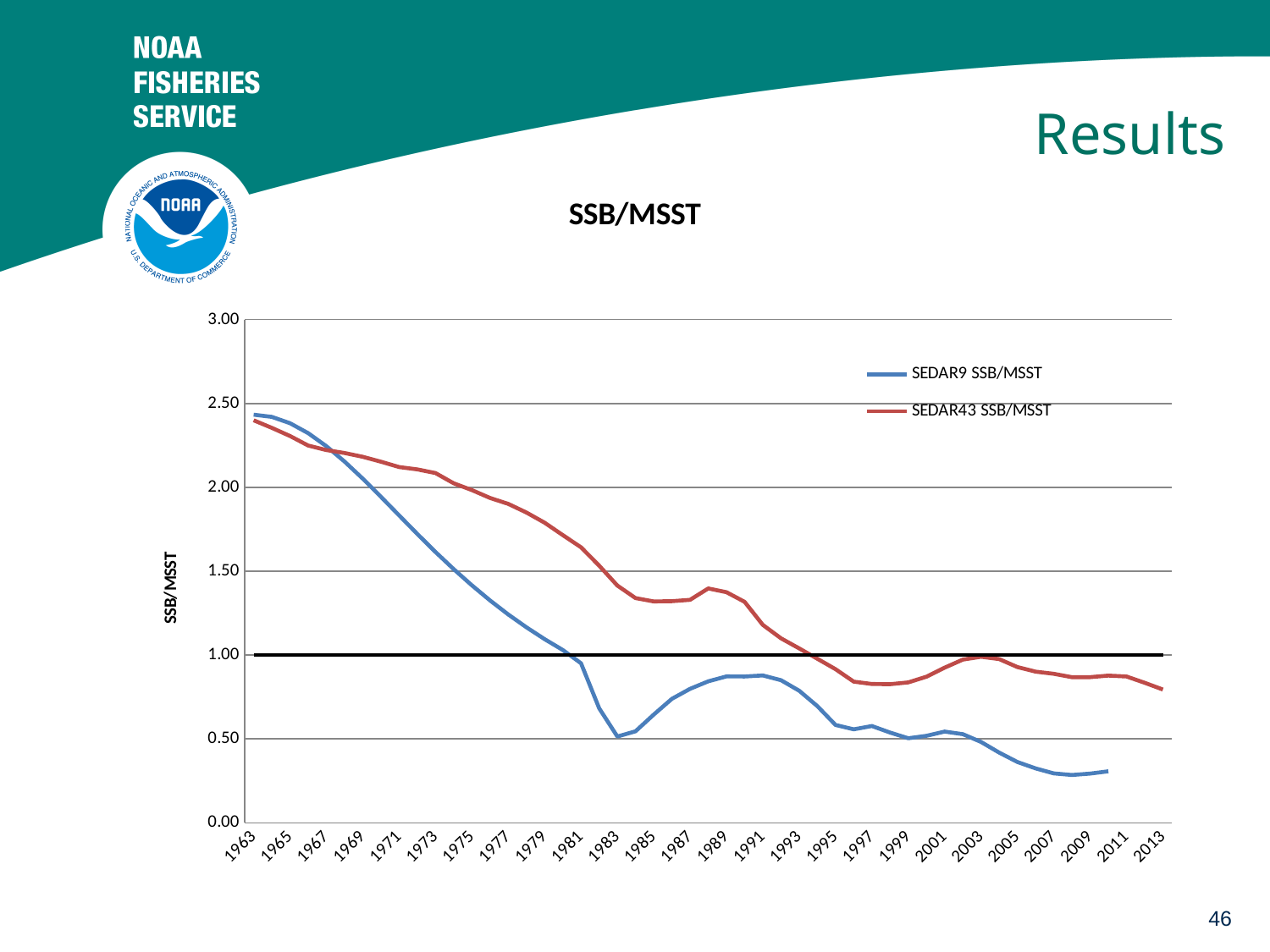
In 1989, which series has the larger value, SEDAR9 SSB/MSST or SEDAR43 SSB/MSST? SEDAR43 SSB/MSST At what value on the y axis is the horizontal black reference line drawn? 1.00 How many series does the legend list? 2 Is the SEDAR43 SSB/MSST value for 2013 greater or less than 1.00? less In 2005, which series has the larger value, SEDAR9 SSB/MSST or SEDAR43 SSB/MSST? SEDAR43 SSB/MSST Which series is drawn in red? SEDAR43 SSB/MSST Is the SEDAR9 SSB/MSST value for 2009 greater or less than 0.50? less Do the SEDAR43 SSB/MSST values generally rise or fall from 1963 to 2013? fall What kind of chart is shown on the slide? line chart Do the SEDAR9 SSB/MSST values generally rise or fall from 1963 to 2009? fall Is the SEDAR9 SSB/MSST value for 1989 greater or less than 1.00? less